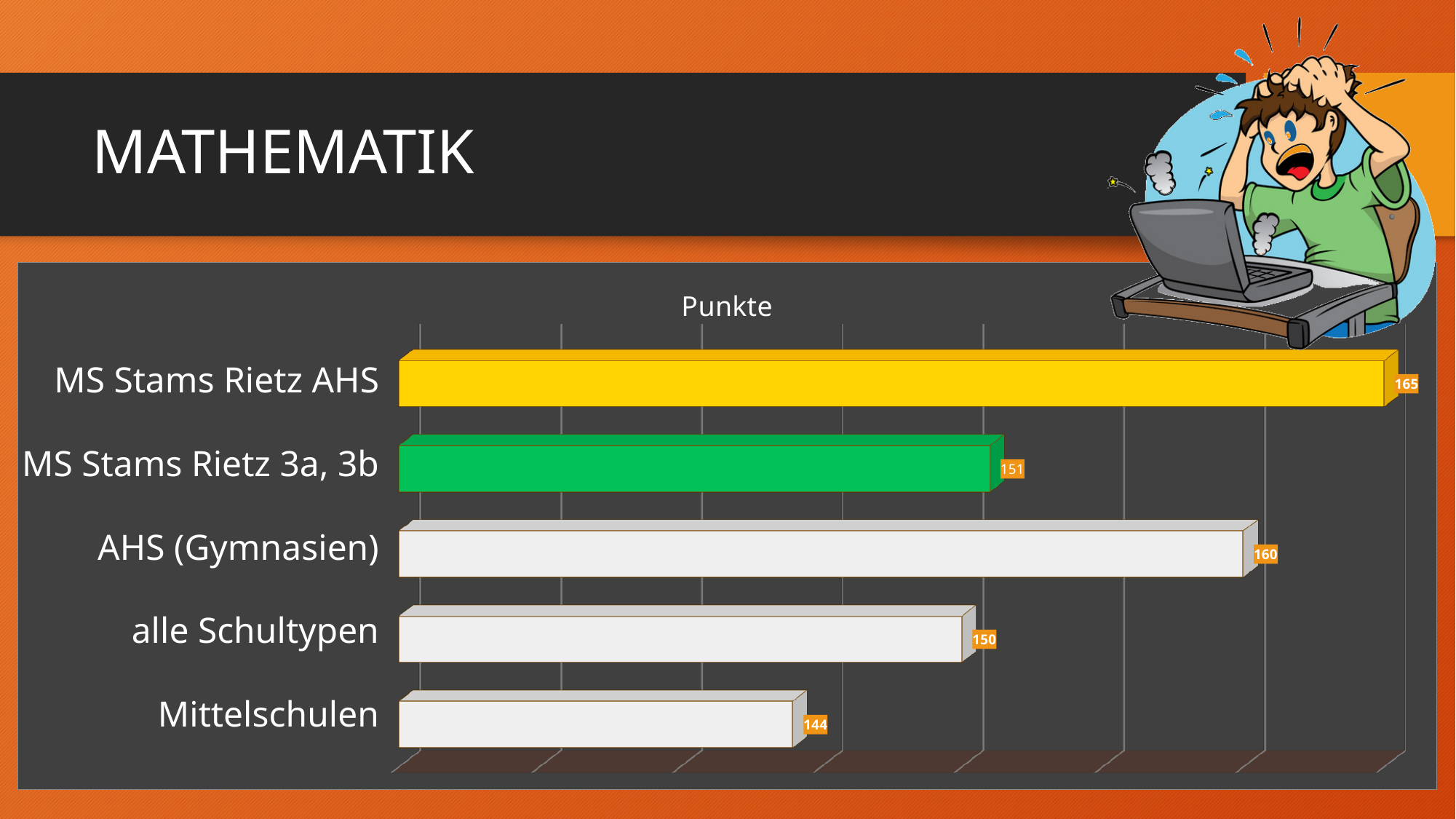
What is the value for AHS (Gymnasien)? 160 What kind of chart is shown on the slide? bar chart What is the value for alle Schultypen? 150 What is the value for Mittelschulen? 144 What is the difference between the values for MS Stams Rietz 3a, 3b and Mittelschulen? 7 Which is larger, the value for MS Stams Rietz 3a, 3b or the value for alle Schultypen? MS Stams Rietz 3a, 3b Which category has the highest value? MS Stams Rietz AHS What is the value for MS Stams Rietz 3a, 3b? 151 What is the value for MS Stams Rietz AHS? 165 Which category has the lowest value? Mittelschulen How many categories are shown in the chart? 5 What is the difference between the values for MS Stams Rietz AHS and AHS (Gymnasien)? 5